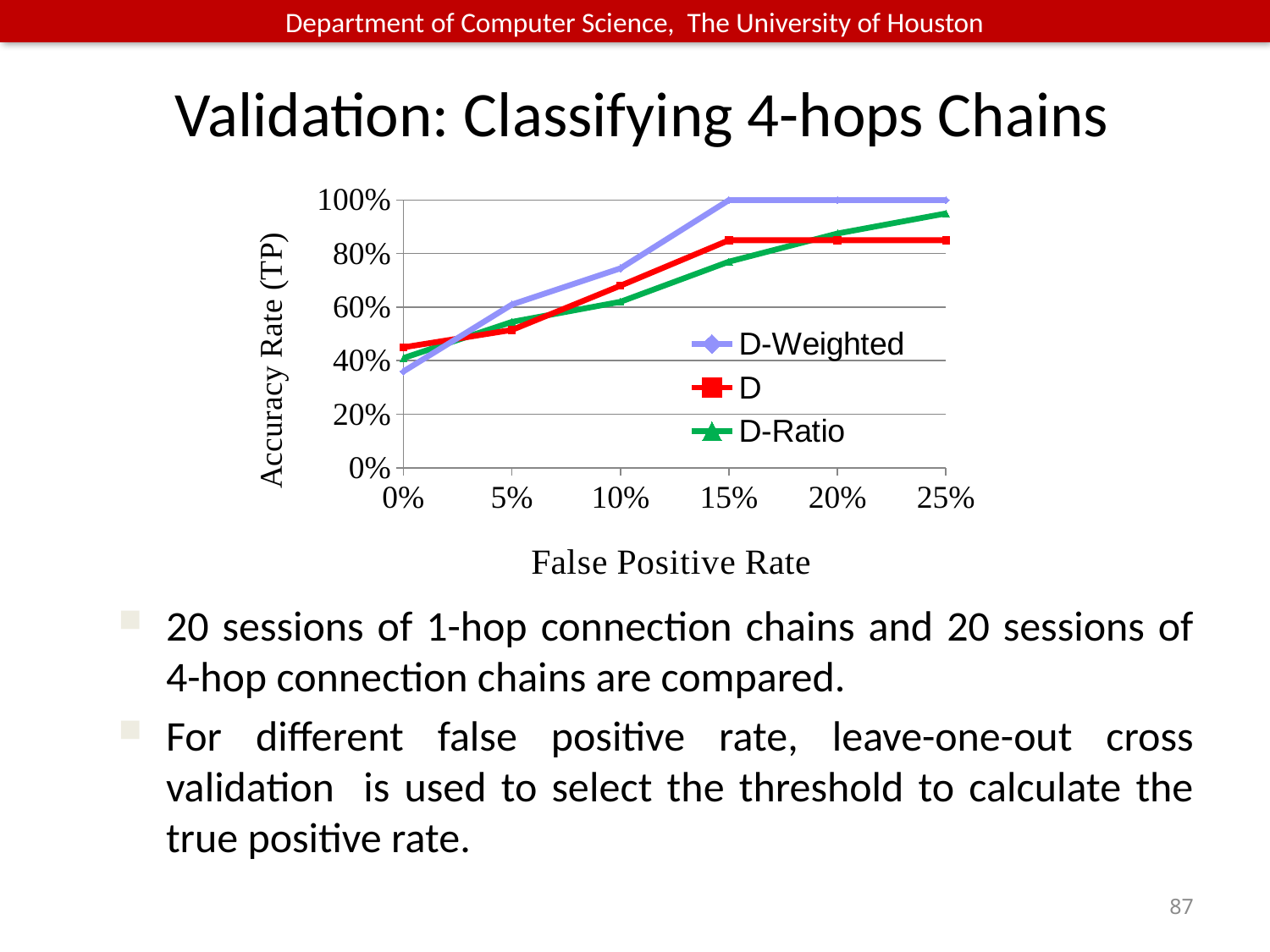
What is the accuracy rate for D-Weighted at a false positive rate of 15%? 100% Does the accuracy rate for D-Ratio rise or fall as the false positive rate increases from 0% to 25%? rise Is the accuracy rate for D-Weighted at a false positive rate of 0% greater or less than 40%? less What kind of chart is shown on the slide? line chart How many false positive rate values are plotted along the x axis? 6 At a false positive rate of 0%, which is larger: the accuracy rate for D or for D-Weighted? D How many series does the legend list? 3 Which series has the lowest accuracy rate at a false positive rate of 25%? D At a false positive rate of 15%, which is larger: the accuracy rate for D-Weighted or for D-Ratio? D-Weighted Is the accuracy rate for D at a false positive rate of 25% greater or less than 80%? greater Which series has the highest accuracy rate at a false positive rate of 25%? D-Weighted What is the accuracy rate for D-Weighted at a false positive rate of 25%? 100%